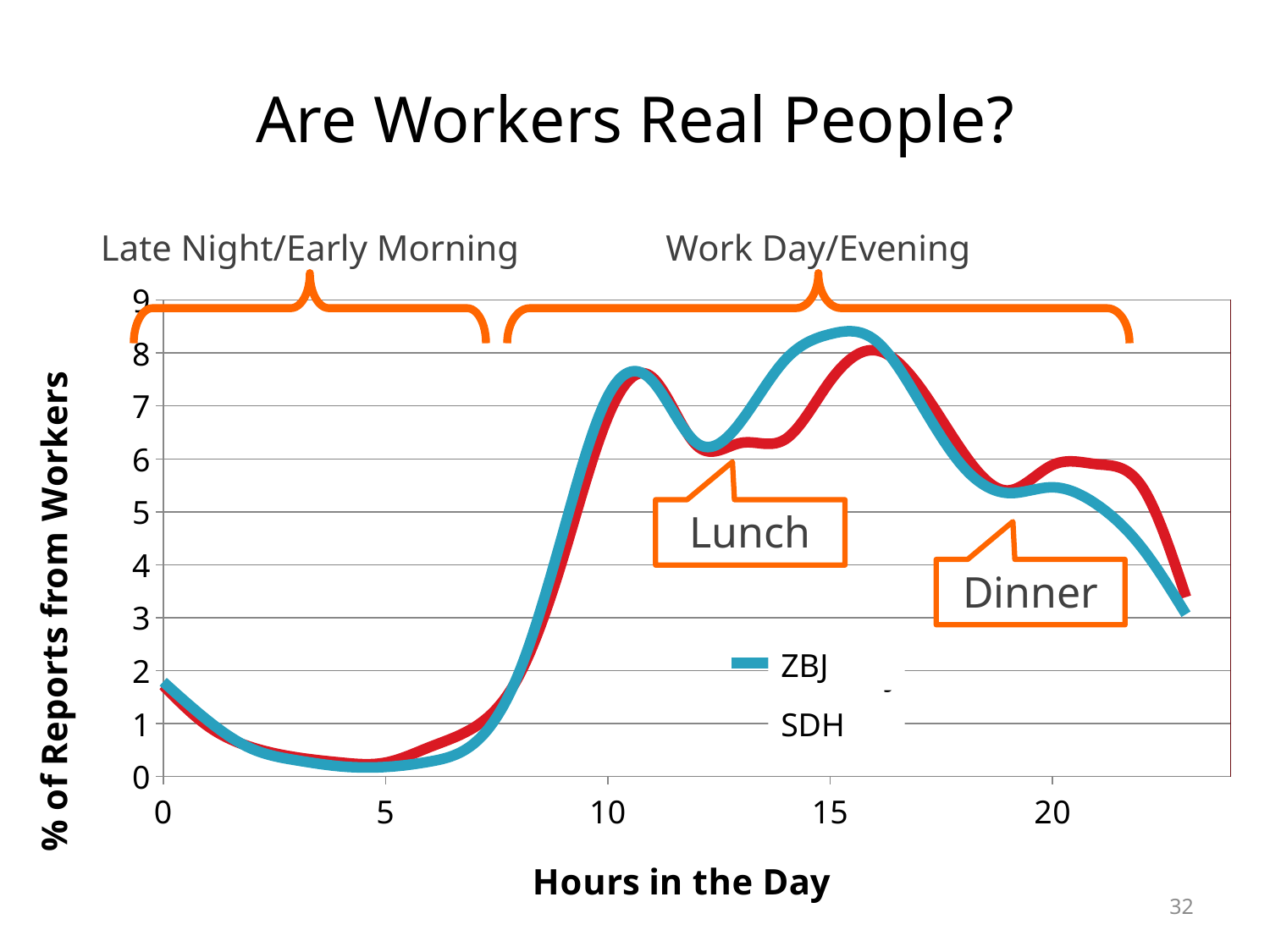
Is the value for ZBJ at hour 0 greater or less than 1? greater How many series does the legend list? 2 At hour 15, which series has the higher value, ZBJ or SDH? ZBJ Is the value for SDH at hour 11 greater or less than 5? greater Is the value for SDH at hour 5 greater or less than 1? less What are the two series named in the legend? ZBJ and SDH Do the values for SDH rise or fall between hour 7 and hour 10? rise Do the values for ZBJ rise or fall between hour 0 and hour 5? fall What is the title of the x axis? Hours in the Day At hour 21, which series has the higher value, ZBJ or SDH? SDH What kind of chart is shown on the slide? line chart